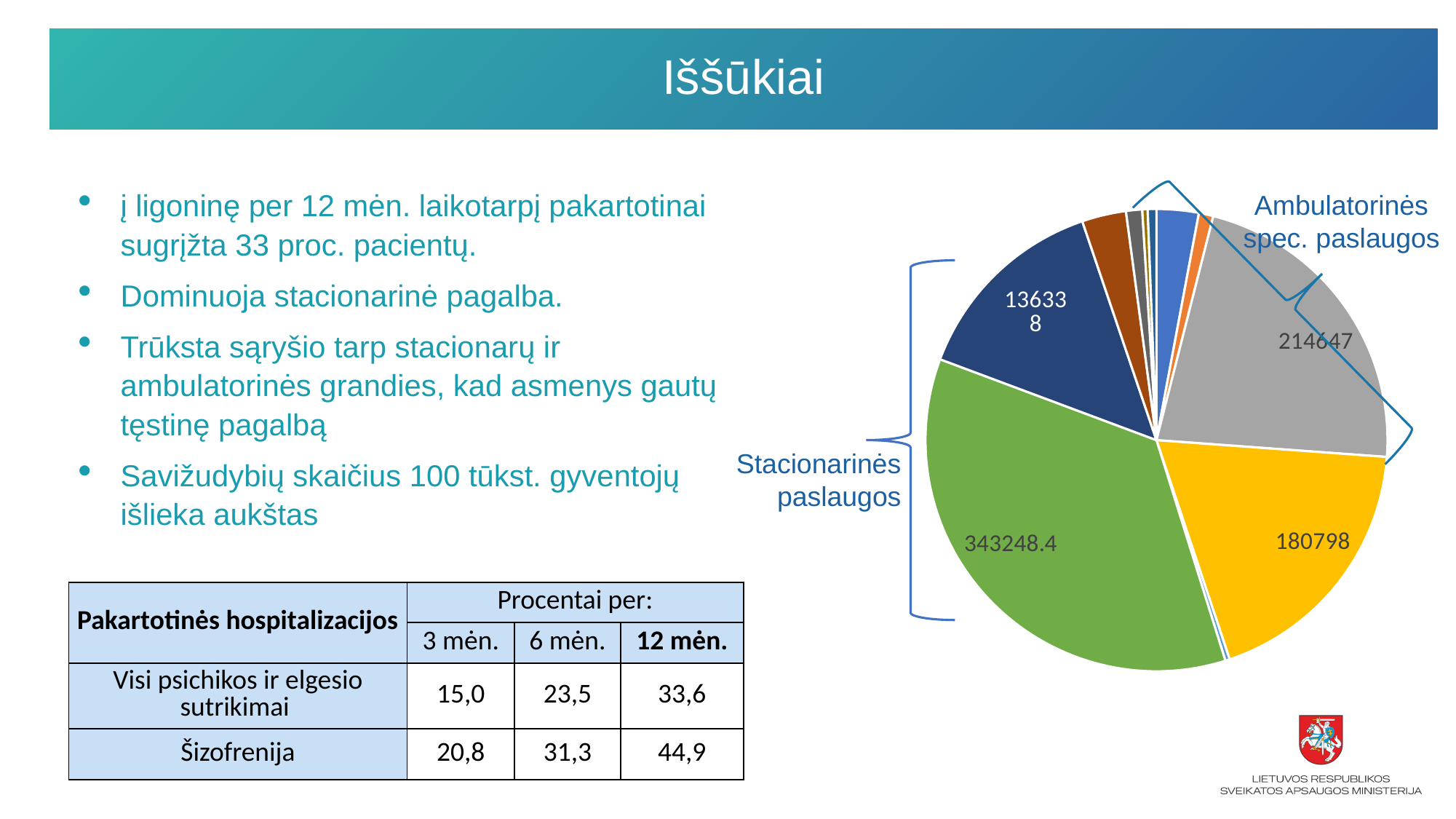
What value is printed on the dark blue slice of the pie chart? 136338 Which slice of the pie chart has the largest printed value? the green slice (343248.4) Which is larger in the pie chart, the gray slice or the yellow slice? the gray slice What value is printed on the green slice of the pie chart? 343248.4 What is the difference between the green slice (343248.4) and the dark blue slice (136338) in the pie chart? 206910.4 Among the slices with printed values, which has the smallest value? the dark blue slice (136338) What value is printed on the yellow slice of the pie chart? 180798 Which group label is attached by a bracket to the left side of the pie chart? Stacionarinės paslaugos What kind of chart is shown on the right side of the slide? pie chart What value is printed on the gray slice of the pie chart? 214647 What is the difference between the gray slice (214647) and the yellow slice (180798) in the pie chart? 33849 How many slices of the pie chart have a value printed on them? 4